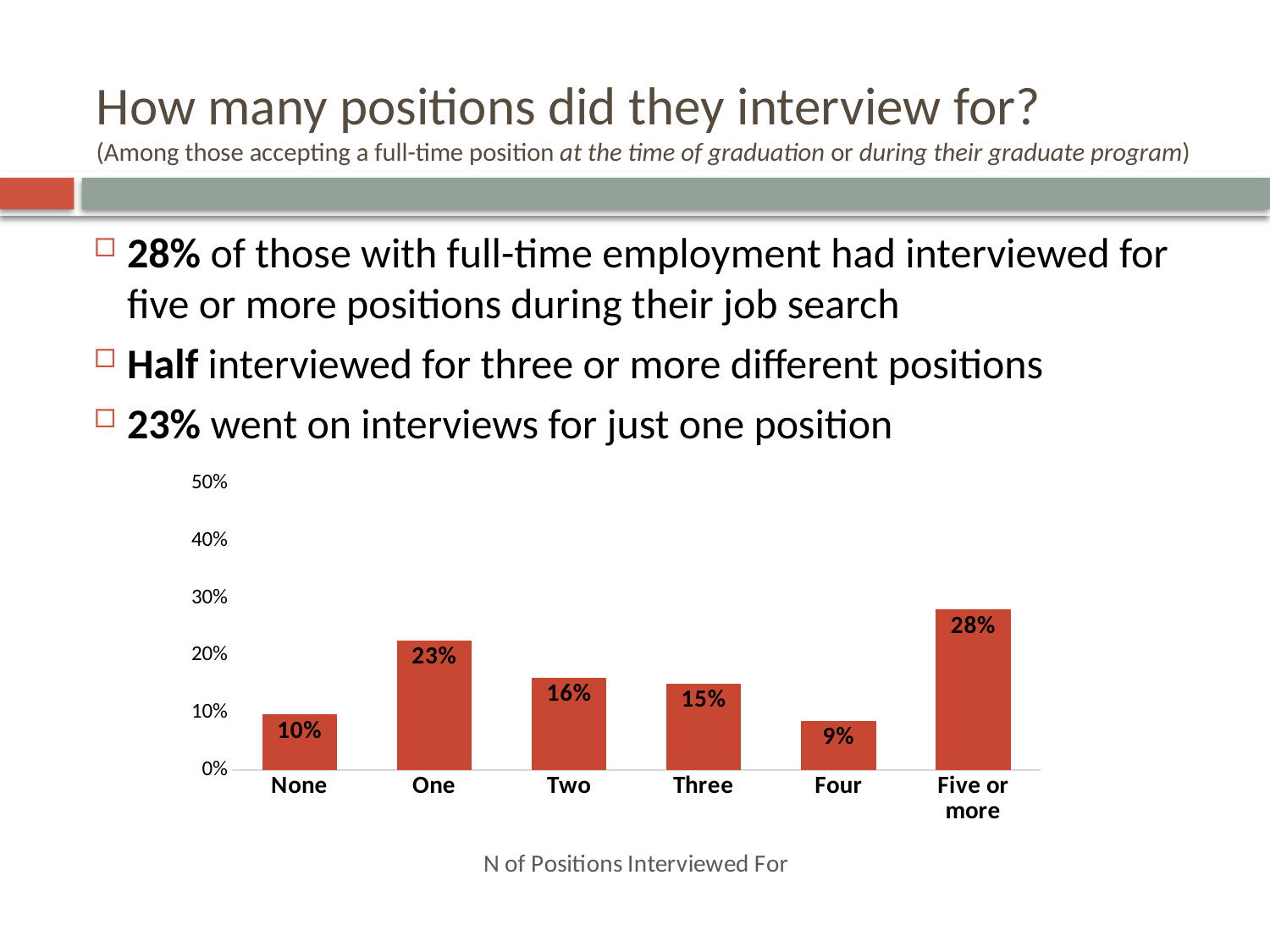
Which is larger, the value for 'Two' or the value for 'Three'? Two Which category has the highest value? Five or more How many categories are shown on the x axis? 6 What is the difference between the values for 'Five or more' and 'Three'? 13% What percentage interviewed for exactly two positions? 16% What kind of chart is shown on the slide? Bar chart Is the value for 'One' greater or less than 20%? greater Which category has the lowest value? Four What is the value shown for the 'None' category? 10% What is the difference between the values for 'One' and 'None'? 13% What percentage of respondents interviewed for five or more positions? 28% What is the label shown below the x axis of the chart? N of Positions Interviewed For